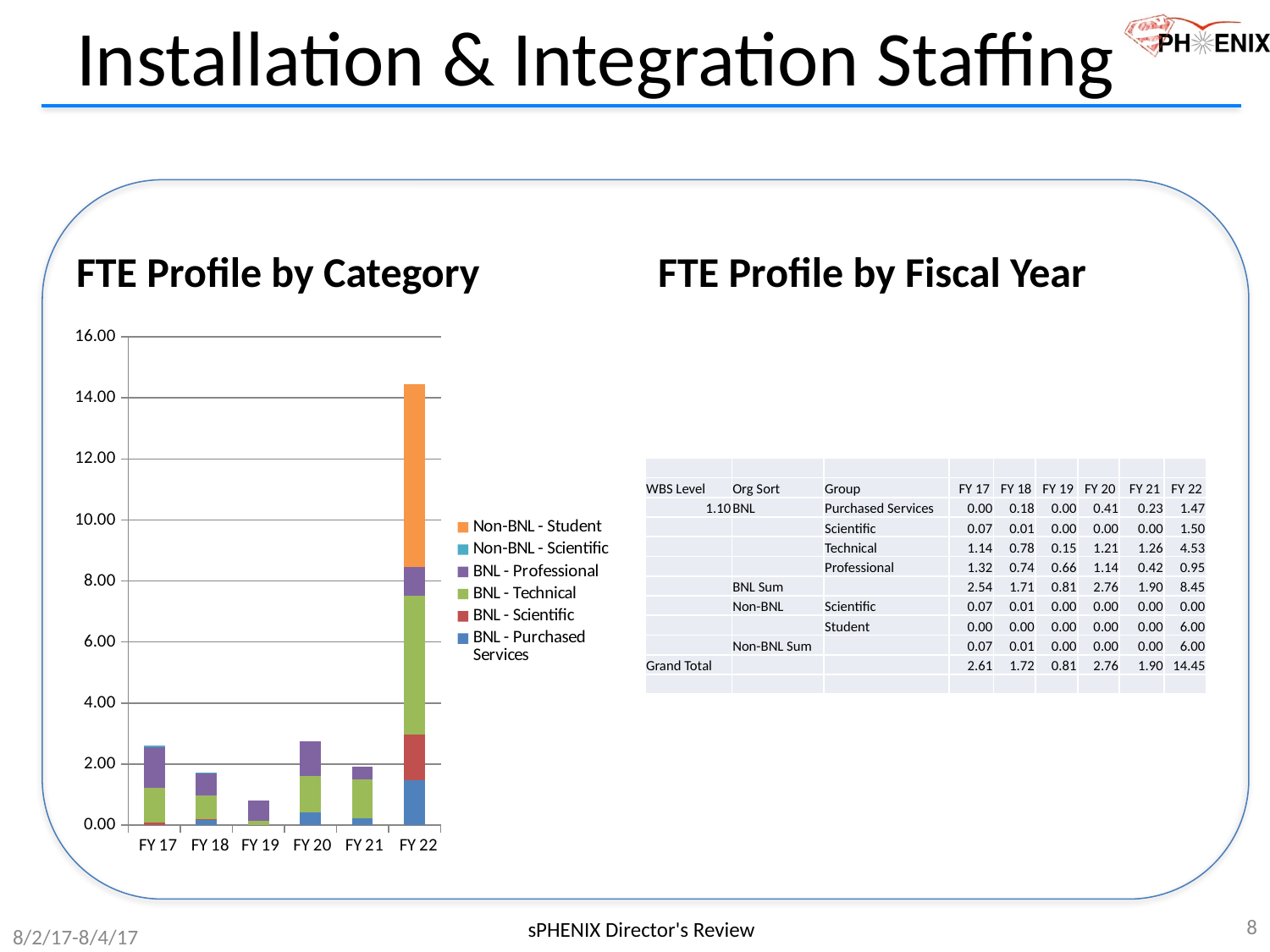
How many series does the legend of the 'FTE Profile by Category' chart list? 6 In the 'FTE Profile by Category' chart, is the total bar for FY 22 greater or less than 12.00? greater In the 'FTE Profile by Category' chart, is the total bar for FY 17 greater or less than 2.00? greater In the 'FTE Profile by Category' chart, is the total bar for FY 19 greater or less than 2.00? less What type of chart is 'FTE Profile by Category'? Stacked bar chart In the 'FTE Profile by Category' chart, do the total values rise or fall from FY 21 to FY 22? rise What is the highest value labelled on the y axis of the 'FTE Profile by Category' chart? 16.00 In the 'FTE Profile by Category' chart, which fiscal year has the shortest stacked bar? FY 19 In the 'FTE Profile by Category' chart, which stacked bar is taller, FY 20 or FY 18? FY 20 In the 'FTE Profile by Category' chart, which legend entry is shown in orange? Non-BNL - Student In the 'FTE Profile by Category' chart, which fiscal year has the tallest stacked bar? FY 22 How many fiscal years are shown on the x axis of the 'FTE Profile by Category' chart? 6